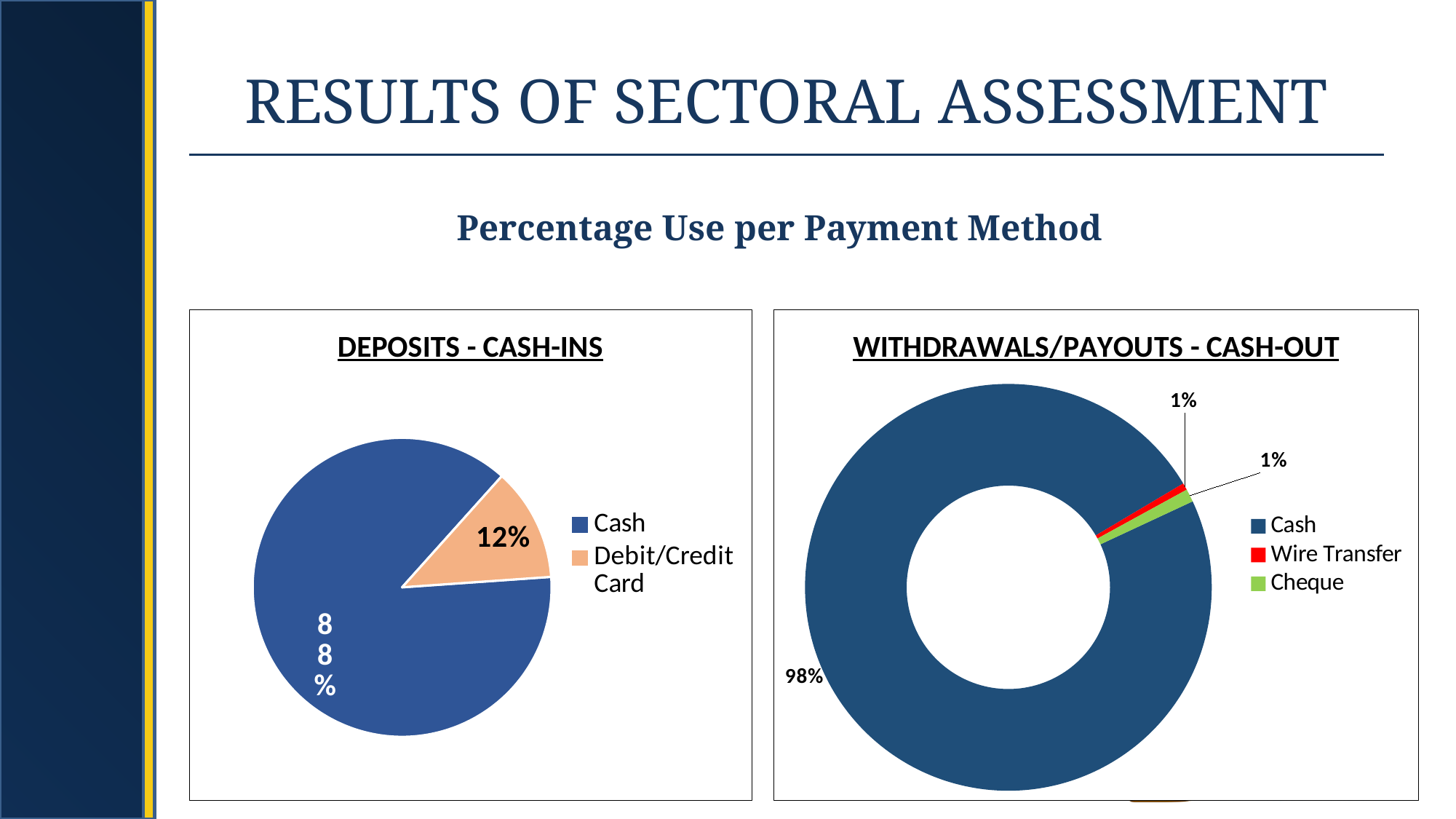
In the WITHDRAWALS/PAYOUTS - CASH-OUT chart, how many payment methods does the legend list? 3 In the WITHDRAWALS/PAYOUTS - CASH-OUT chart, what percentage is shown for Cheque? 1% In the DEPOSITS - CASH-INS chart, what percentage is shown for Cash? 88% In the DEPOSITS - CASH-INS chart, how many payment methods does the legend list? 2 In the WITHDRAWALS/PAYOUTS - CASH-OUT chart, what percentage is shown for Cash? 98% In the WITHDRAWALS/PAYOUTS - CASH-OUT chart, what colour represents Wire Transfer? Red In the DEPOSITS - CASH-INS chart, what is the difference in percentage points between Cash and Debit/Credit Card? 76 In the WITHDRAWALS/PAYOUTS - CASH-OUT chart, which payment method has the largest share? Cash What kind of chart is the DEPOSITS - CASH-INS chart? Pie chart In the WITHDRAWALS/PAYOUTS - CASH-OUT chart, what percentage is shown for Wire Transfer? 1% In the DEPOSITS - CASH-INS chart, which payment method has the largest share? Cash In the DEPOSITS - CASH-INS chart, what percentage is shown for Debit/Credit Card? 12%